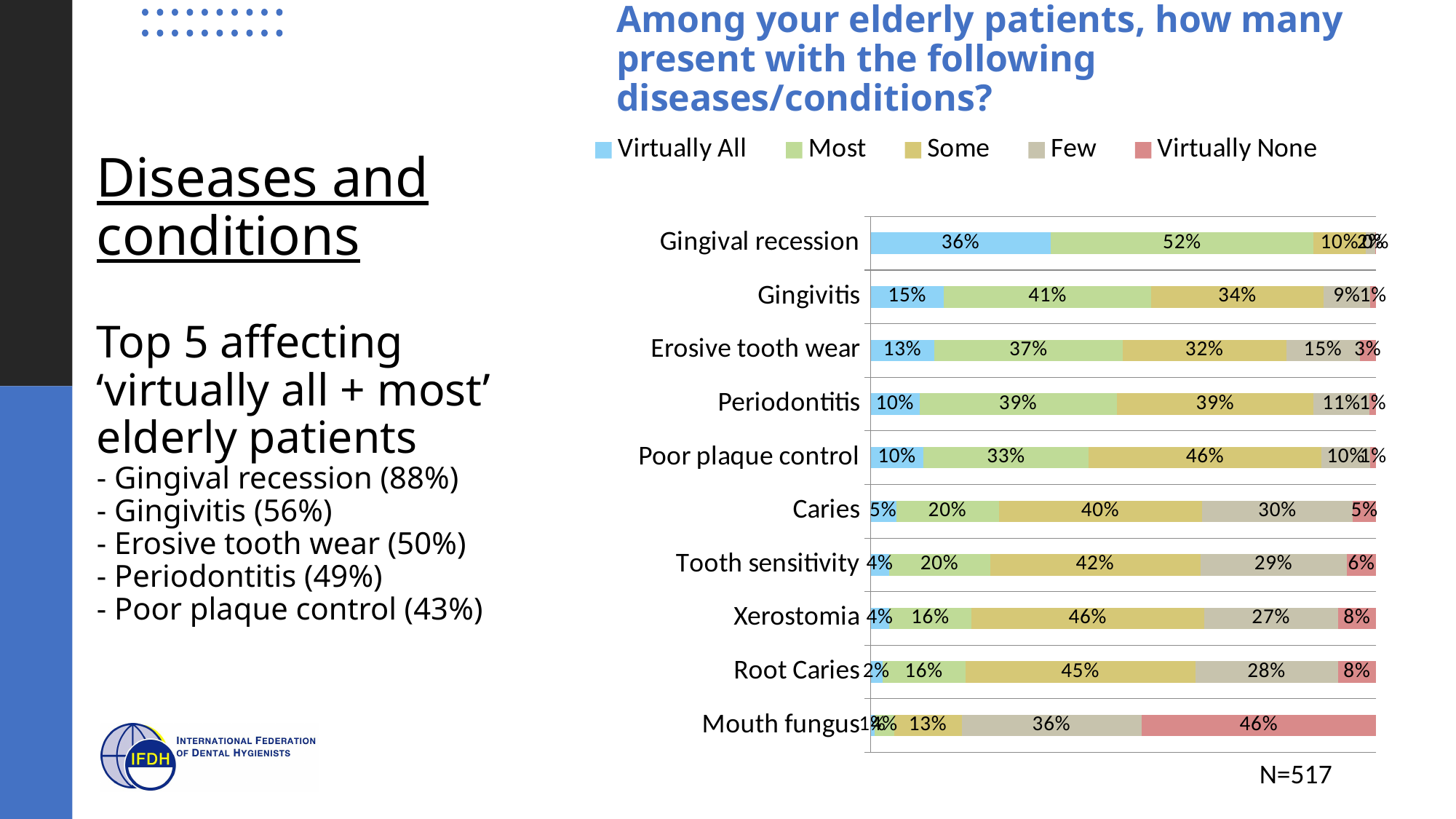
What is the 'Few' value for Mouth fungus? 36% What is the first entry in the chart's legend? Virtually All For Gingivitis, what is the difference between the 'Most' value and the 'Virtually All' value? 26 percentage points How many series does the legend list? 5 Which condition has the highest 'Virtually All' value? Gingival recession How many diseases/conditions are plotted on the chart? 10 What is the 'Virtually None' value for Mouth fungus? 46% What is the 'Some' value for Poor plaque control? 46% Which condition has the highest 'Virtually None' value? Mouth fungus Which is larger: the 'Few' value for Erosive tooth wear or the 'Few' value for Periodontitis? Erosive tooth wear What is the 'Most' value for Gingival recession? 52% What kind of chart is shown on the slide? Stacked bar chart